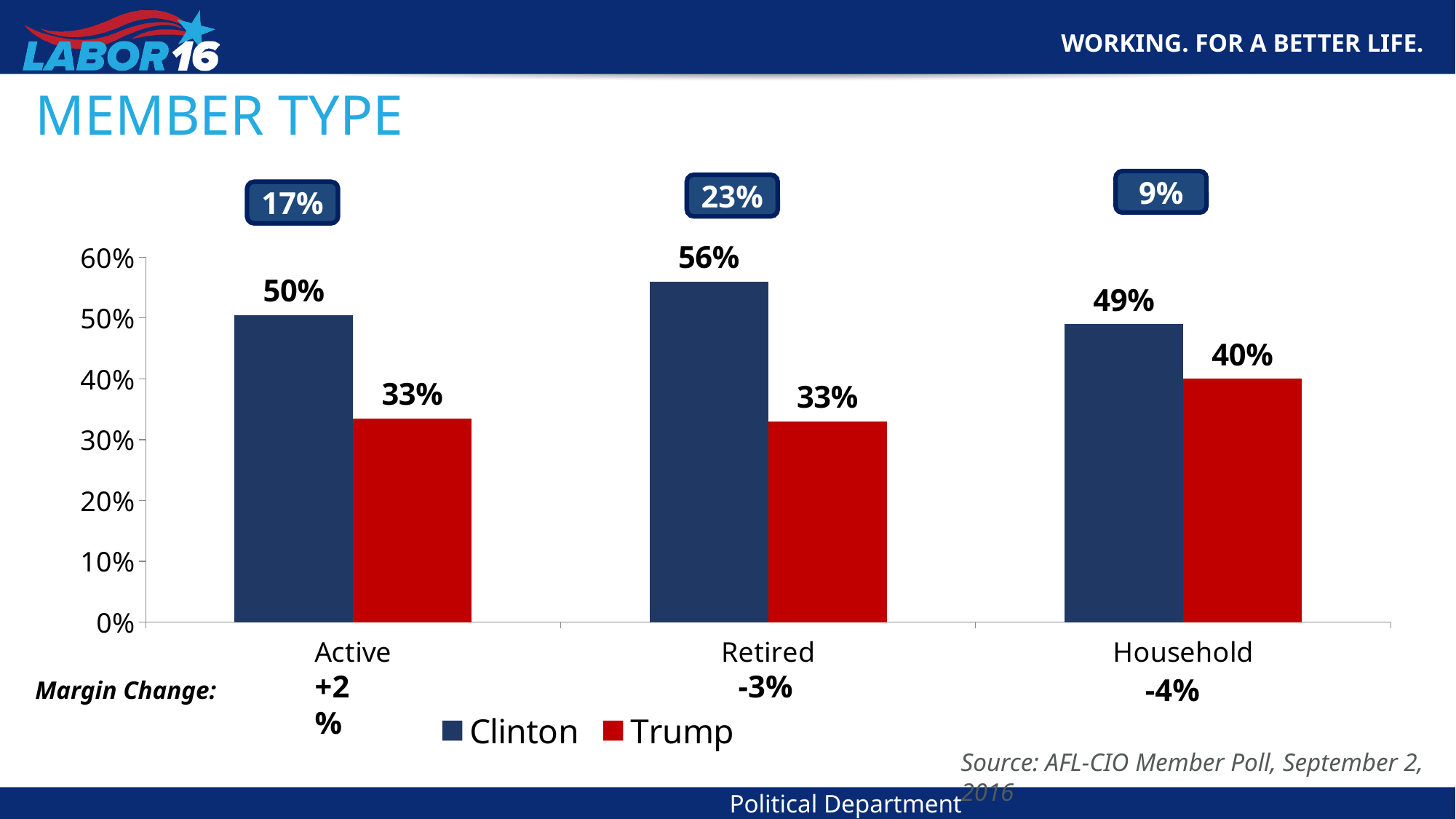
What is the value for Trump among Retired members? 33% What kind of chart is shown on the slide? bar chart Which is larger among Household members, the Clinton value or the Trump value? Clinton Which member type has the highest value for Clinton? Retired Which member type has the lowest value for Clinton? Household What is the value for Clinton among Active members? 50% What is the difference between Clinton and Trump among Retired members? 23% How many member type categories are shown on the x axis? 3 What is the value for Trump among Household members? 40% Is the value for Trump among Active members greater or less than 40%? less What is the margin change shown for Household members? -4% How many series does the legend list? 2